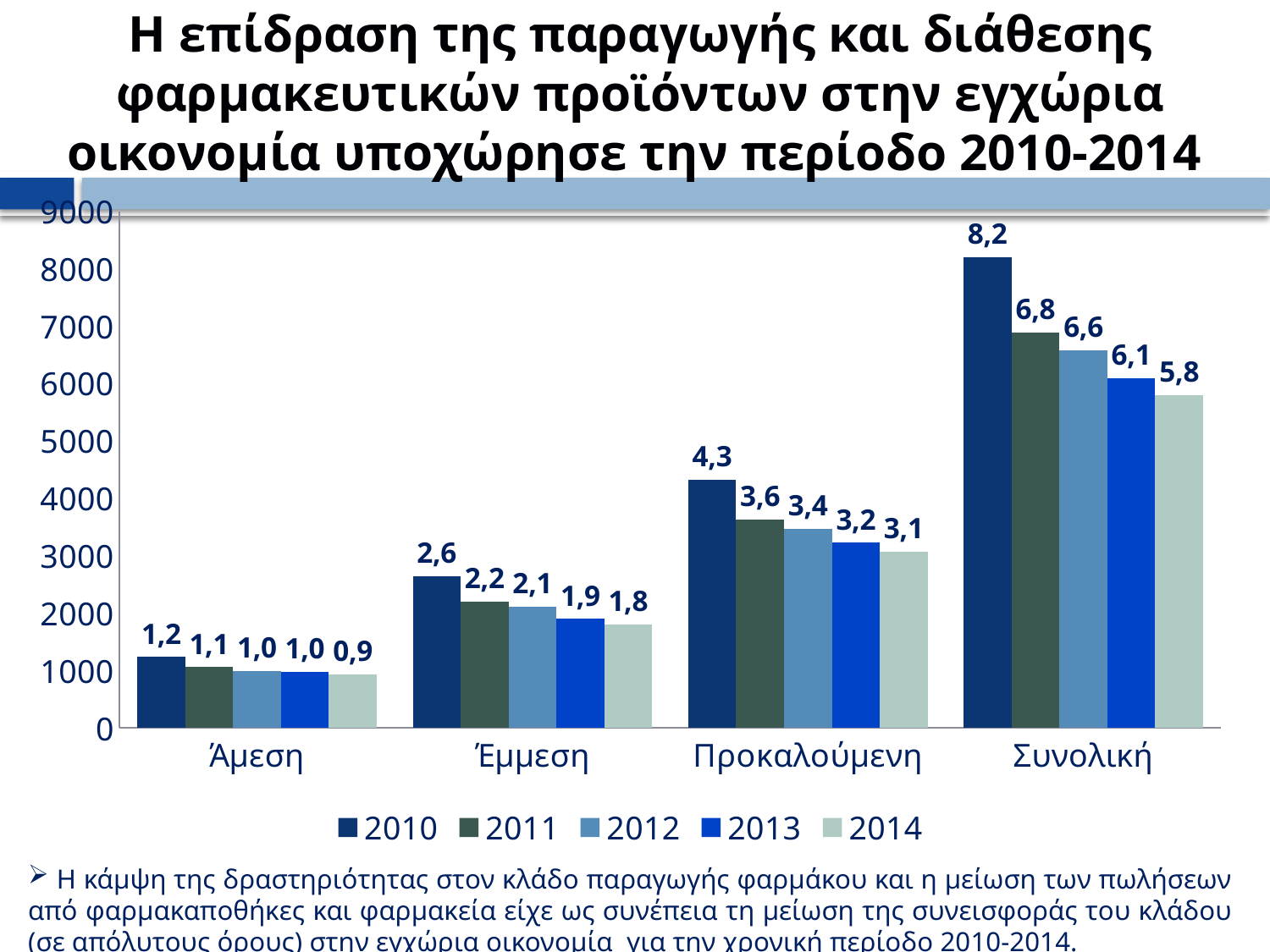
What is the value for Έμμεση in 2014? 1,8 How many categories are shown on the x axis? 4 What is the difference between the Συνολική values for 2010 and 2014? 2,4 What is the value for Συνολική in 2010? 8,2 How many series does the legend list? 5 Which is larger: the value for Έμμεση in 2010 or the value for Προκαλούμενη in 2014? Προκαλούμενη in 2014 Do the values for Συνολική rise or fall from 2010 to 2014? fall What is the value for Προκαλούμενη in 2013? 3,2 Which year has the lowest value for Προκαλούμενη? 2014 Which year has the highest value for Συνολική? 2010 Which legend entry is shown in the lightest colour? 2014 What type of chart is shown on the slide? bar chart